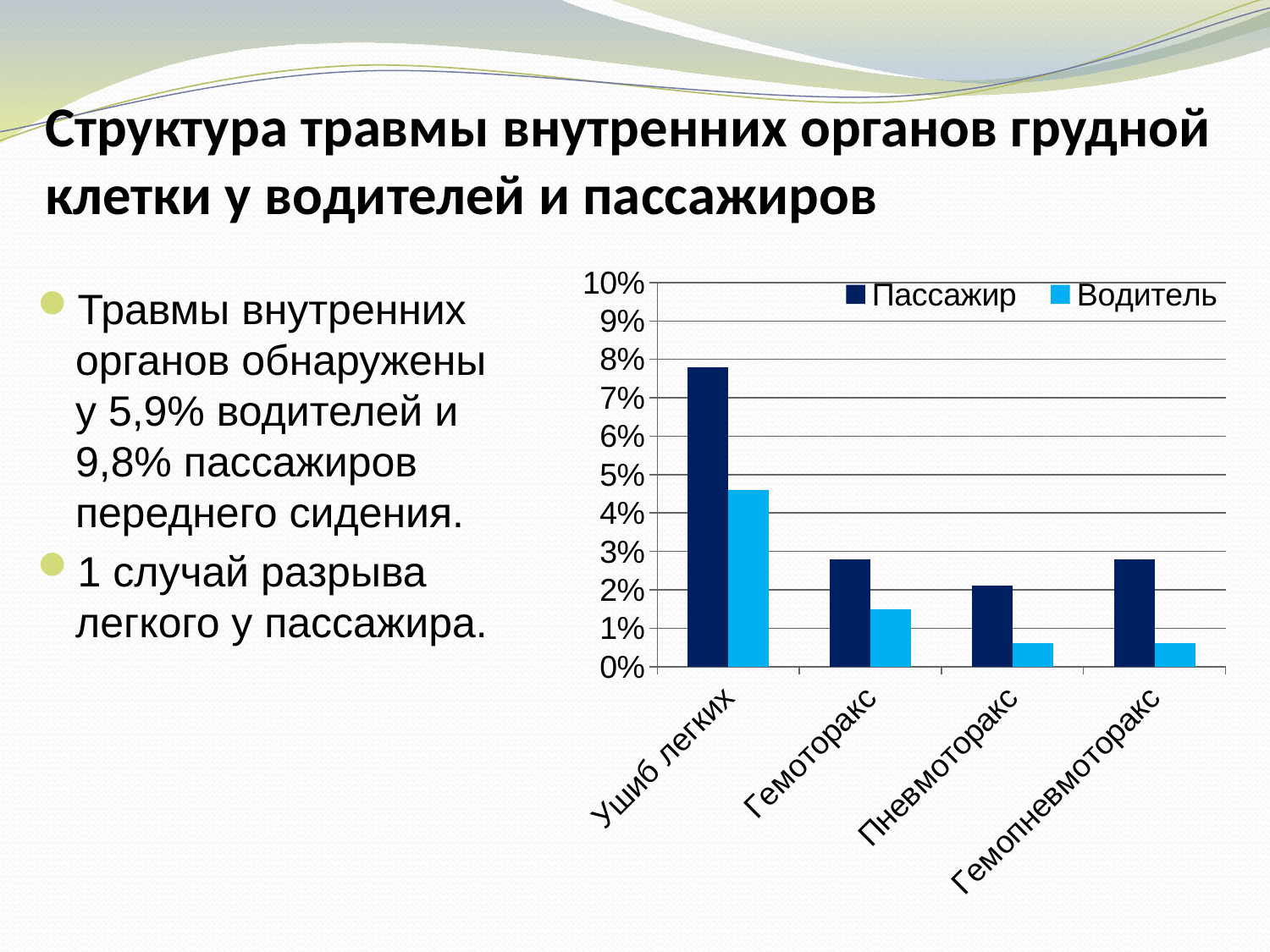
What kind of chart is shown on the slide? bar chart Is the value for Водитель in Пневмоторакс greater or less than 1%? less How many categories are shown on the x axis of the chart? 4 For Гемопневмоторакс, which is larger: the value for Пассажир or for Водитель? Пассажир Is the value for Пассажир in Гемоторакс greater or less than 2%? greater How many series does the chart legend list? 2 Is the value for Водитель in Ушиб легких greater or less than 5%? less Which category has the highest value for Водитель? Ушиб легких What are the two series named in the chart legend? Пассажир and Водитель Which category has the lowest value for Пассажир? Пневмоторакс Which category has the highest value for Пассажир? Ушиб легких